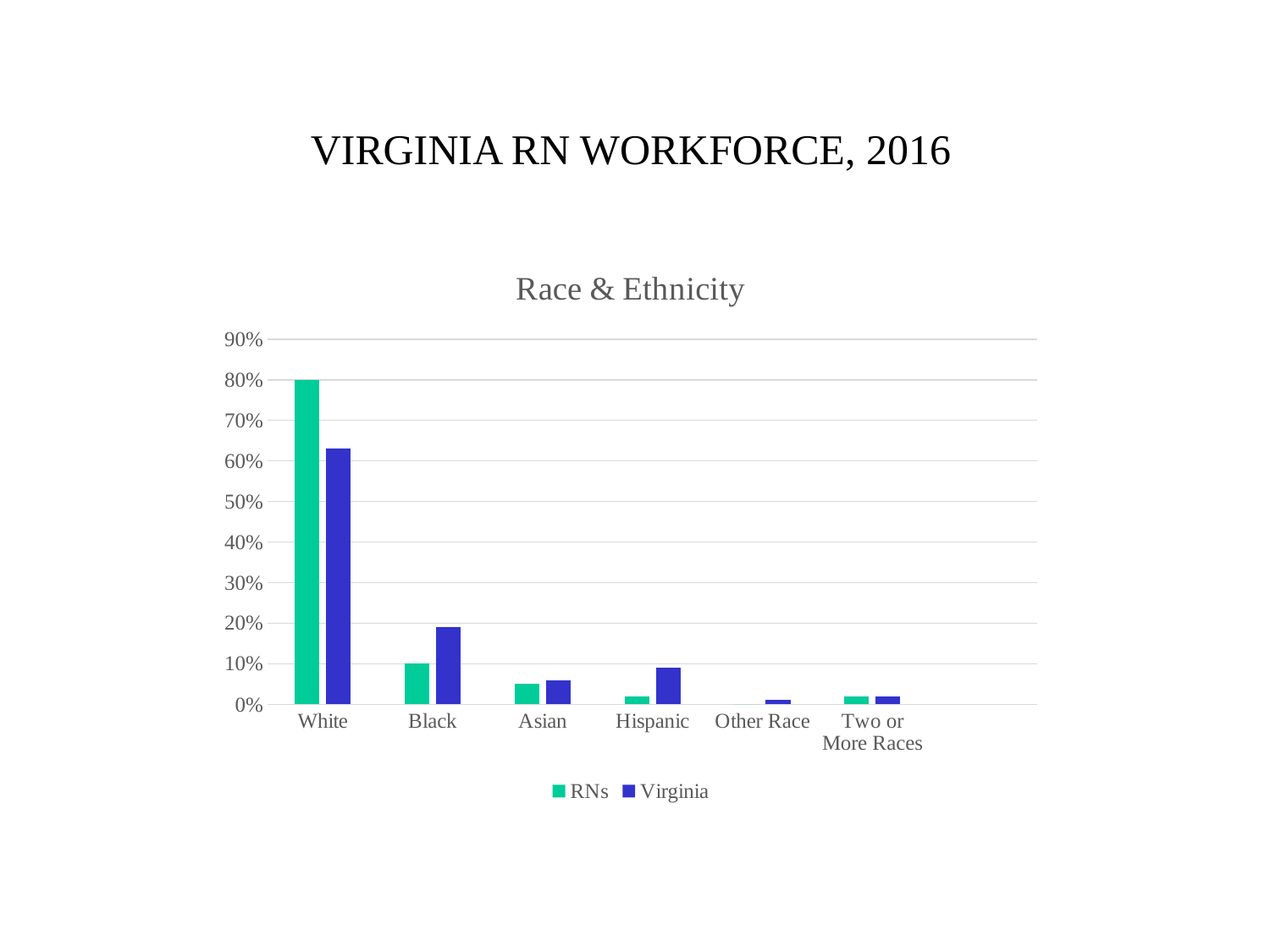
Is the Virginia value for Black greater or less than 10%? greater For the White category, which is larger: the RNs value or the Virginia value? RNs What kind of chart is shown on the slide? bar chart Is the Virginia value for White greater or less than 60%? greater How many series does the legend list? 2 Which category has the highest value for the RNs series? White For the Hispanic category, which is larger: the RNs value or the Virginia value? Virginia Which category has the highest value for the Virginia series? White What are the two series named in the legend? RNs and Virginia What is the title of the chart? Race & Ethnicity How many race/ethnicity categories are shown on the x axis? 6 For the Black category, which is larger: the RNs value or the Virginia value? Virginia